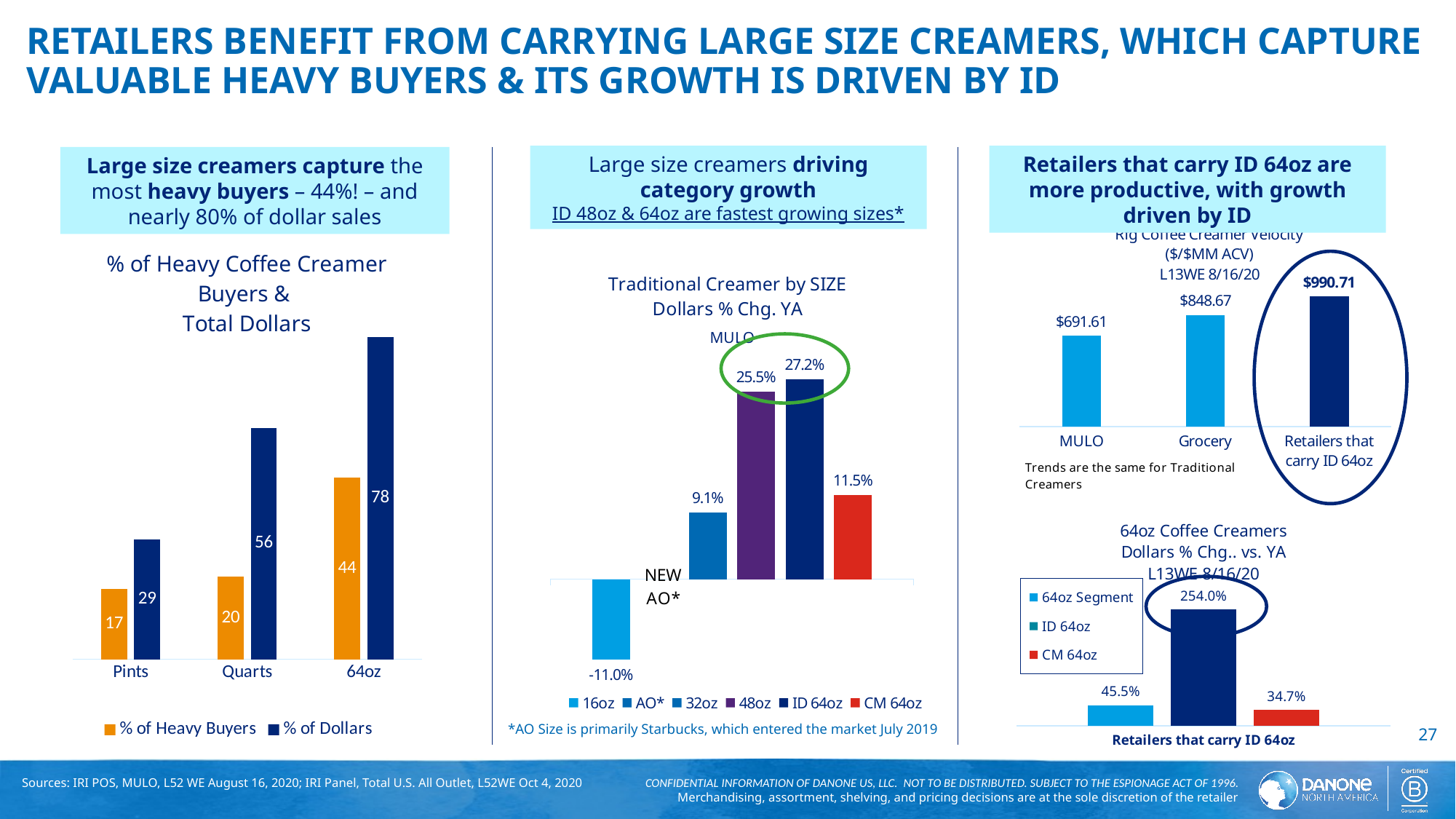
In the '% of Heavy Coffee Creamer Buyers & Total Dollars' chart, what is the % of Heavy Buyers value for 64oz? 44 In the 'Traditional Creamer by SIZE Dollars % Chg. YA' chart, what is the value for 48oz? 25.5% In the '64oz Coffee Creamers Dollars % Chg.. vs. YA' chart, what is the value for ID 64oz? 254.0% In the '% of Heavy Coffee Creamer Buyers & Total Dollars' chart, what is the % of Dollars value for Quarts? 56 In the '% of Heavy Coffee Creamer Buyers & Total Dollars' chart, how many series does the legend list? 2 In the 'RIG Coffee Creamer Velocity' chart, which category has the lowest value? MULO In the 'Traditional Creamer by SIZE Dollars % Chg. YA' chart, how many entries does the legend list? 6 In the 'Traditional Creamer by SIZE Dollars % Chg. YA' chart, what is the value for 16oz? -11.0% In the 'RIG Coffee Creamer Velocity' chart, what is the value for Grocery? $848.67 In the '% of Heavy Coffee Creamer Buyers & Total Dollars' chart, what is the difference between the % of Dollars and % of Heavy Buyers values for Pints? 12 In the '64oz Coffee Creamers Dollars % Chg.. vs. YA' chart, which is larger, 64oz Segment or CM 64oz? 64oz Segment In the 'Traditional Creamer by SIZE Dollars % Chg. YA' chart, which size has the highest value? ID 64oz